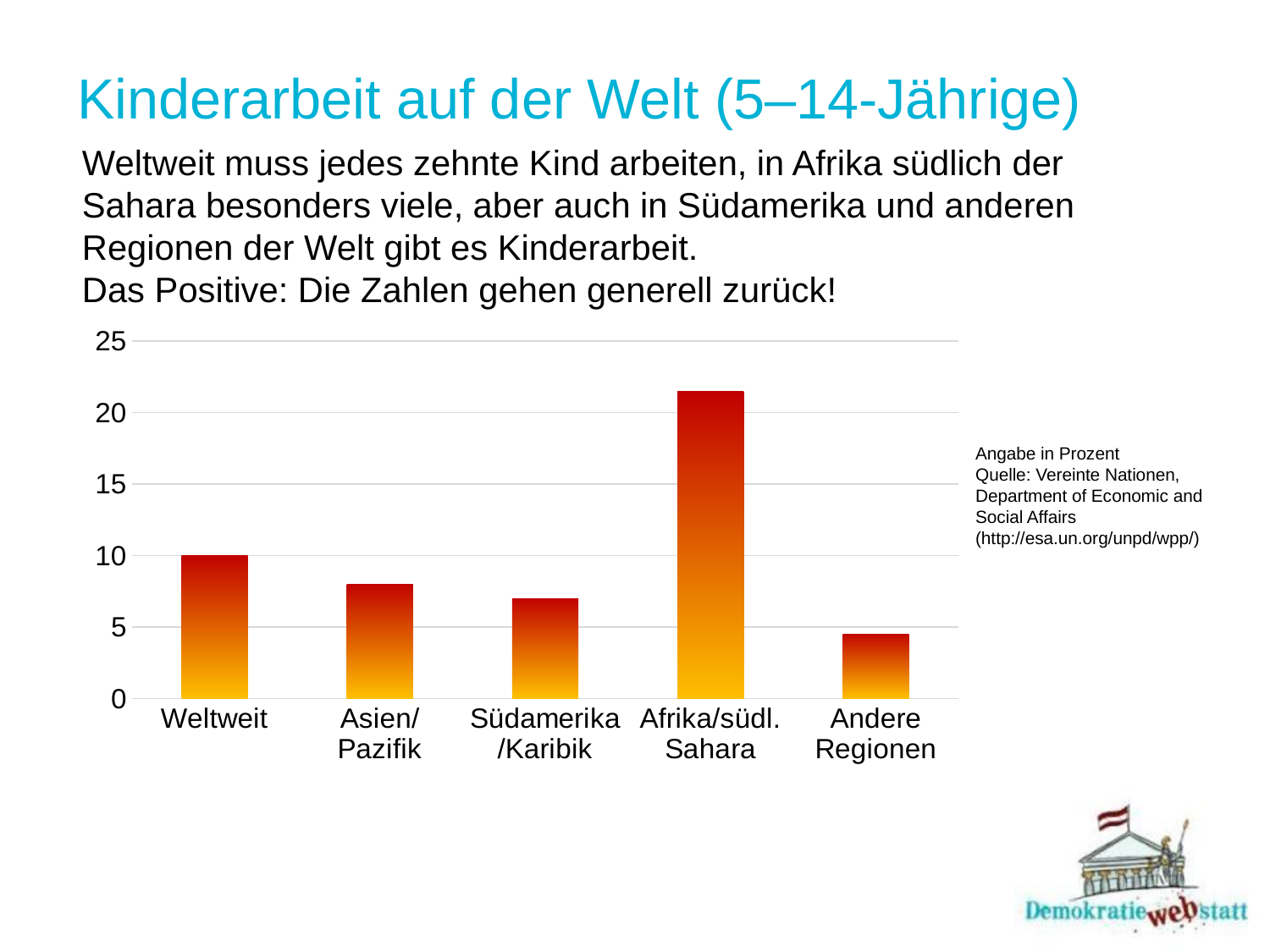
Is the value for Asien/Pazifik greater or less than 10? less Which is larger, the value for Weltweit or the value for Asien/Pazifik? Weltweit Which category has the highest bar in the chart? Afrika/südl. Sahara Which category has the lowest bar in the chart? Andere Regionen What kind of chart is shown on the slide? bar chart What is the value for Weltweit in the chart? 10 In what unit are the values in the chart given, according to the note next to it? Prozent Is the value for Südamerika/Karibik greater or less than 5? greater How many categories are shown on the x axis of the chart? 5 Is the value for Andere Regionen greater or less than 5? less Which is larger, the value for Afrika/südl. Sahara or the value for Südamerika/Karibik? Afrika/südl. Sahara